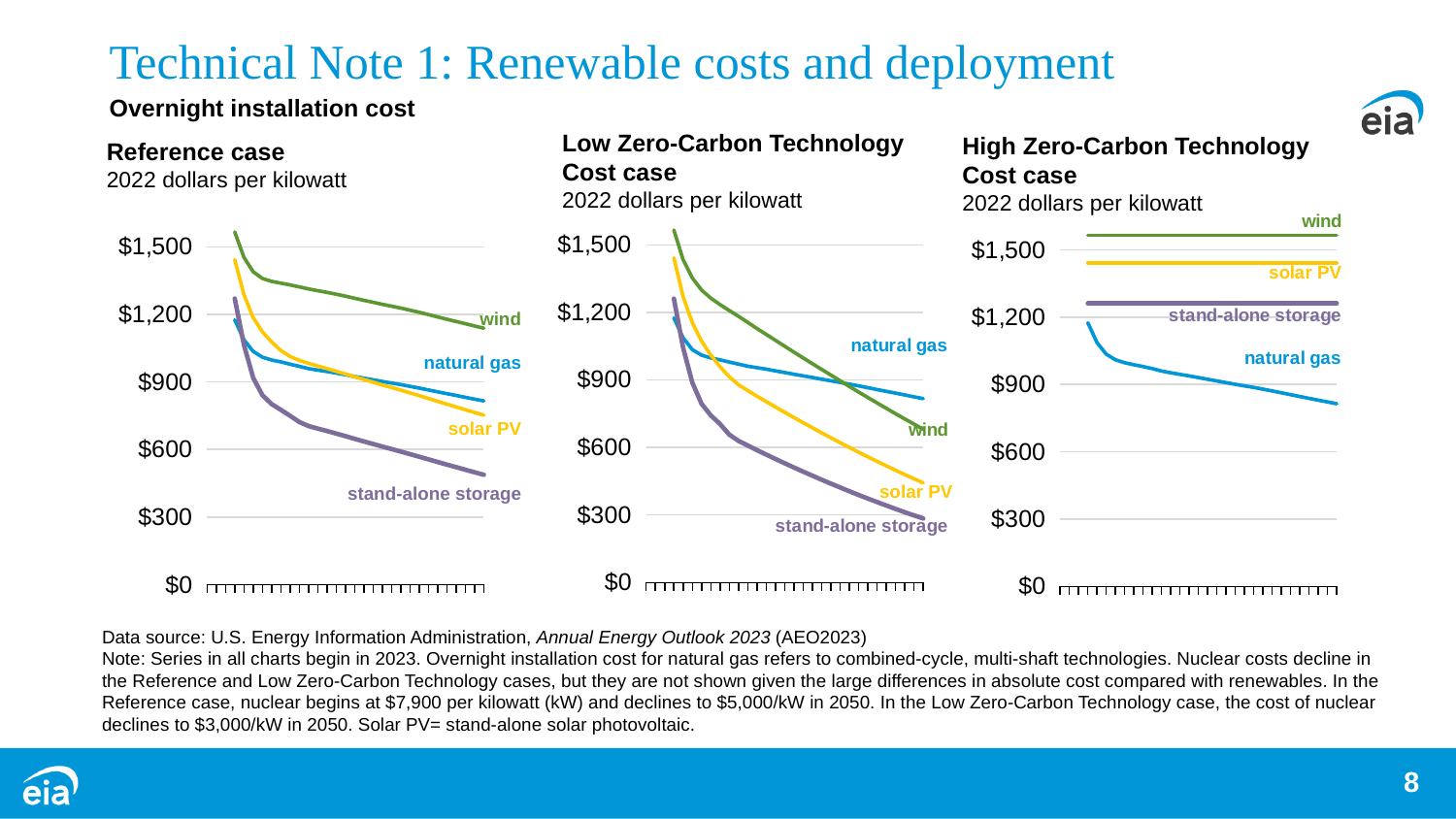
In the Low Zero-Carbon Technology Cost case chart, does the stand-alone storage series rise or fall over time? fall In the High Zero-Carbon Technology Cost case chart, which is higher at the right end: wind or natural gas? wind What type of chart is used in the Reference case chart? line chart In the Reference case chart, which series has the lowest value at the right end of the chart? stand-alone storage In the High Zero-Carbon Technology Cost case chart, is the value for wind greater or less than $1,500? greater In the Reference case chart, which series has the highest value at the right end of the chart? wind In the High Zero-Carbon Technology Cost case chart, is the final value for natural gas greater or less than $900? less How many series are plotted in the Low Zero-Carbon Technology Cost case chart? 4 What unit is used on the y axis of the three charts? 2022 dollars per kilowatt In the Low Zero-Carbon Technology Cost case chart, is the final value for solar PV greater or less than $600? less